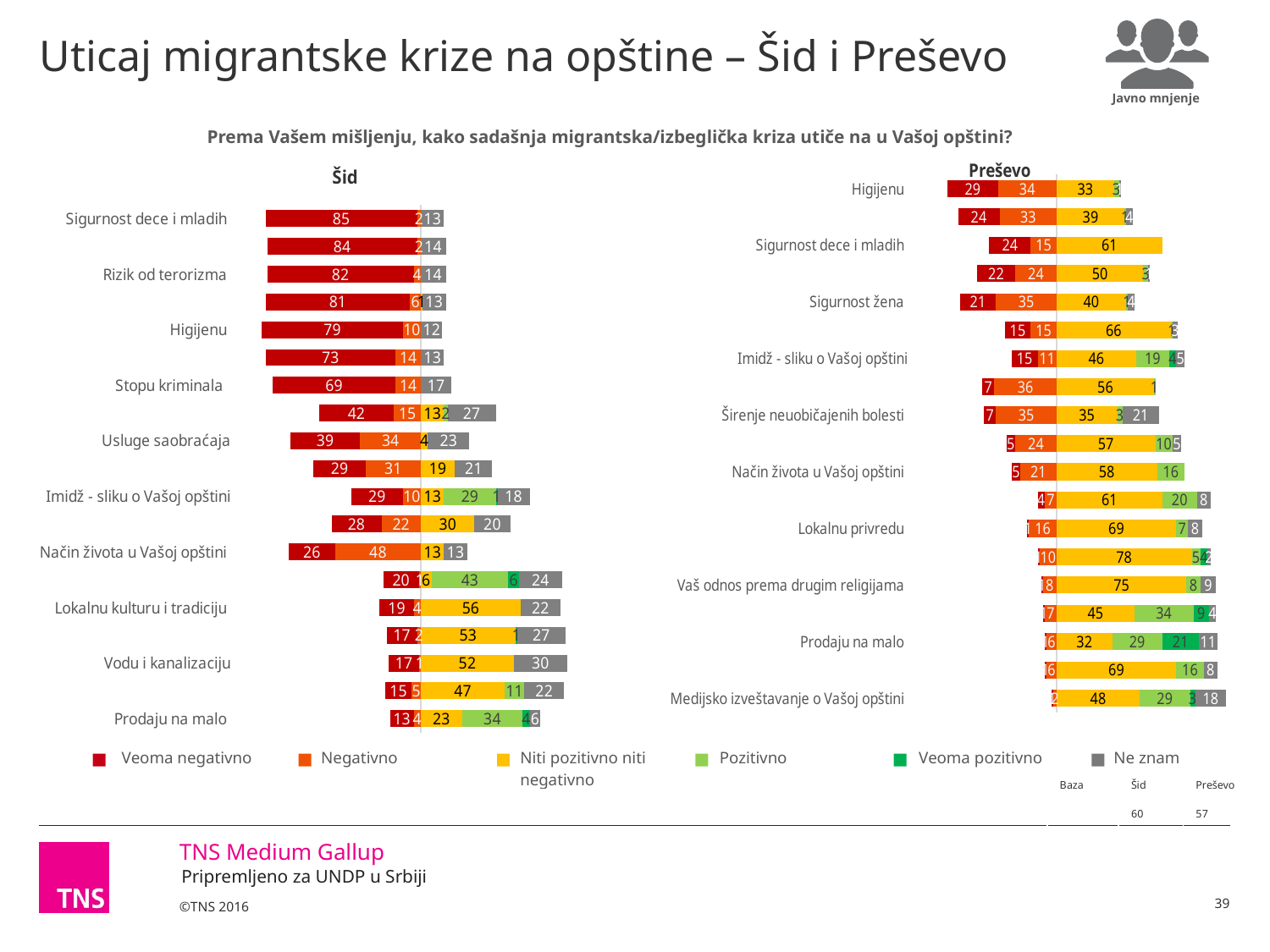
In the Šid chart, which category has the highest 'Veoma negativno' value? Sigurnost dece i mladih In the Šid chart, what is the 'Veoma negativno' value for 'Higijenu'? 79 In the Preševo chart, what is the 'Pozitivno' value for 'Prodaju na malo'? 29 In the Šid chart, what is the 'Veoma negativno' value for 'Sigurnost dece i mladih'? 85 In the Preševo chart, what is the 'Veoma negativno' value for 'Higijenu'? 29 Which municipality has the larger 'Veoma negativno' value for 'Higijenu', Šid or Preševo? Šid What kind of chart is used on this slide for Šid and Preševo? Stacked bar chart What is the difference between the 'Veoma negativno' values for 'Higijenu' in Šid and Preševo? 50 What is the base (Baza) shown for Šid? 60 In the Šid chart, what is the 'Niti pozitivno niti negativno' value for 'Vodu i kanalizaciju'? 52 How many series does the legend list? 6 In the Preševo chart, what is the 'Niti pozitivno niti negativno' value for 'Sigurnost dece i mladih'? 61